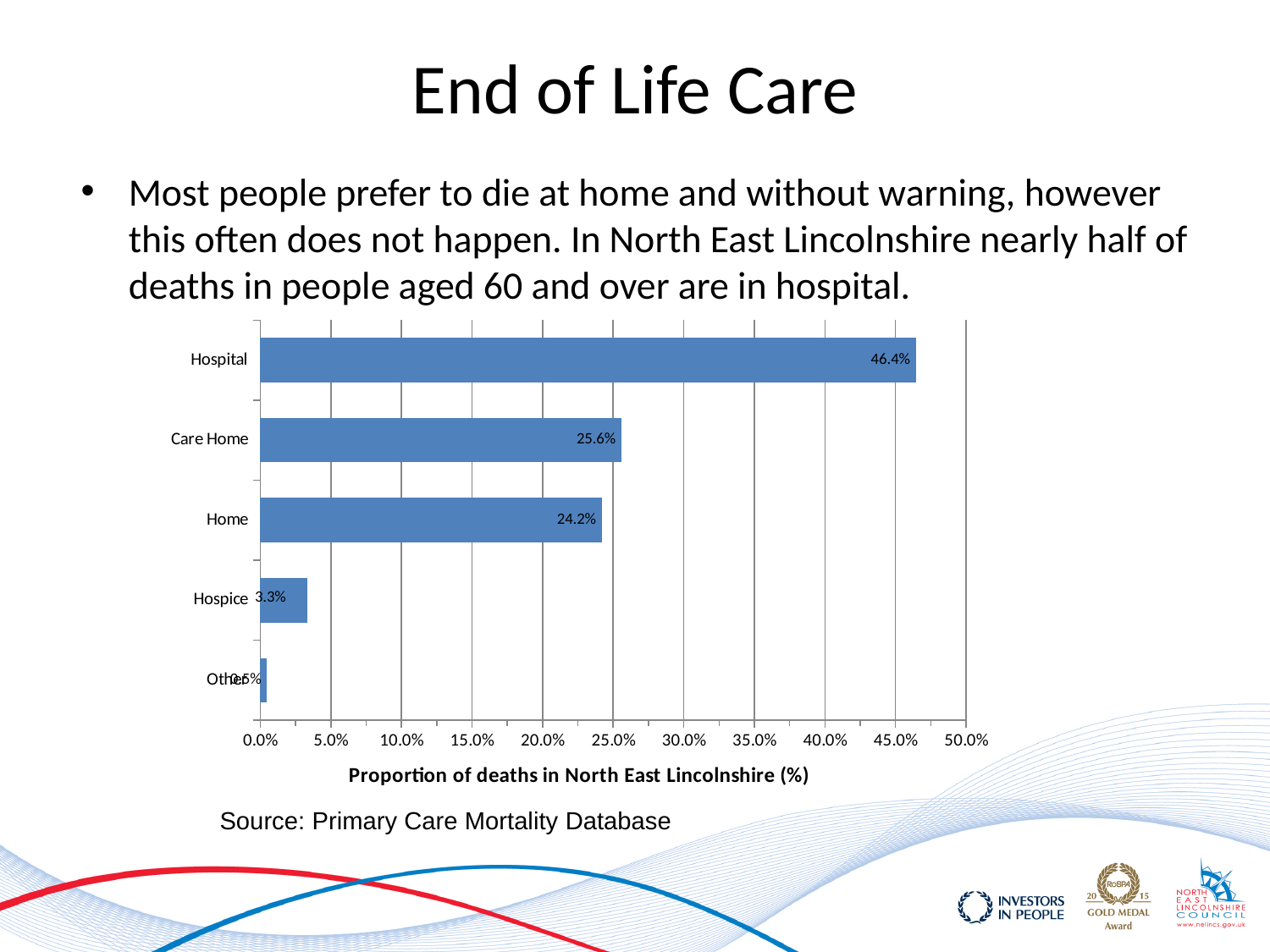
Which place of death has the highest proportion? Hospital How many places of death are shown in the chart? 5 What proportion of deaths occur at Home? 24.2% Which is larger, the value for Care Home or the value for Home? Care Home What is the difference between the Care Home and Home values? 1.4% Which place of death has the lowest proportion? Other What is the value shown for Hospice? 3.3% What is the difference between the Hospital and Care Home values? 20.8% What proportion of deaths in North East Lincolnshire occur in hospital? 46.4% What is the value shown for Care Home? 25.6% What kind of chart is shown on the slide? Bar chart Is the value for Hospital greater or less than 45.0%? greater